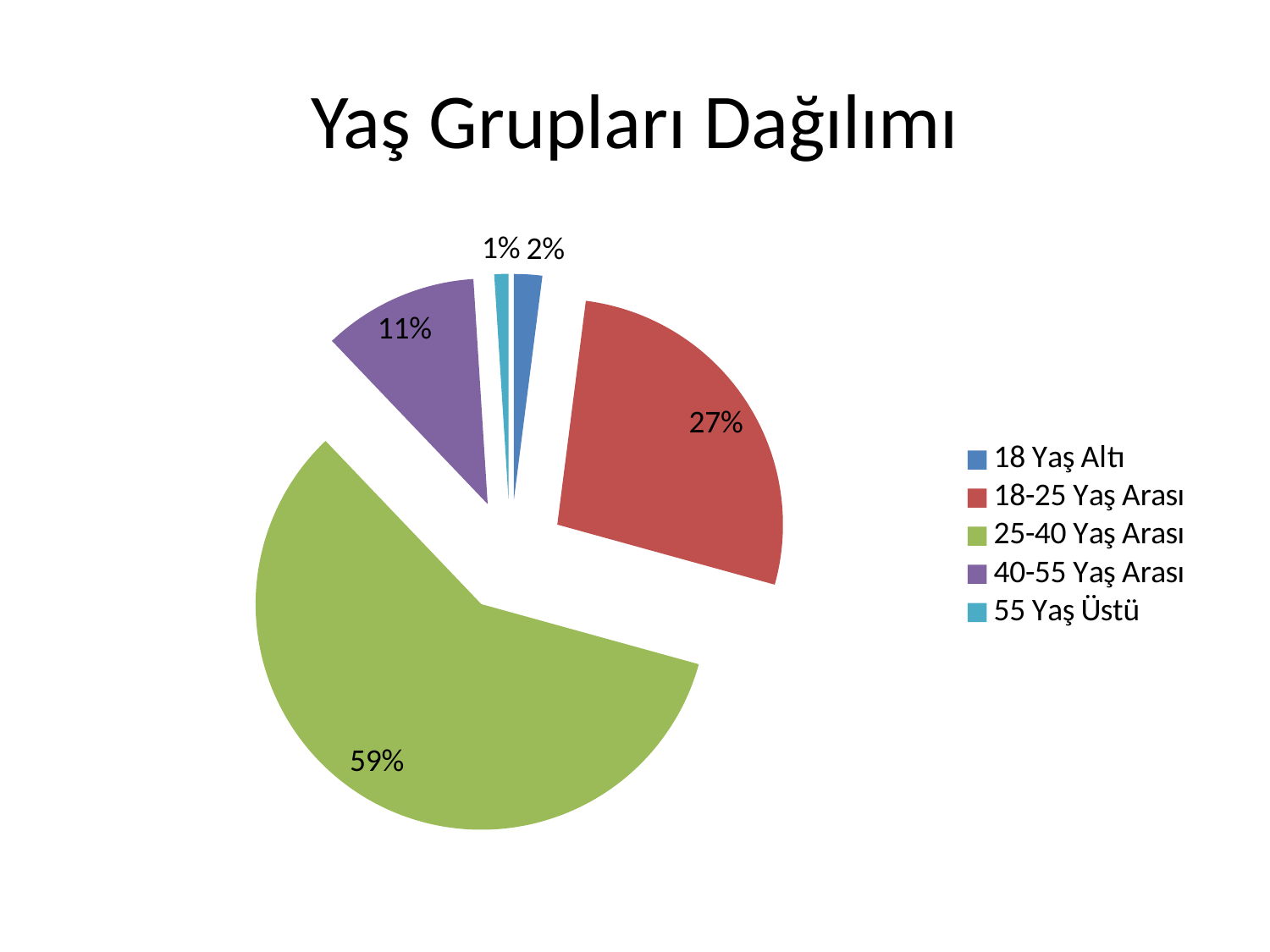
What share of the pie does 25-40 Yaş Arası have? 59% What type of chart is shown on the slide? pie chart What is the difference in percentage points between 25-40 Yaş Arası and 18-25 Yaş Arası? 32 What share of the pie does 18-25 Yaş Arası have? 27% Which age group has the smallest share of the pie? 55 Yaş Üstü What share of the pie does 55 Yaş Üstü have? 1% Which age group has the largest share of the pie? 25-40 Yaş Arası What is the title of the chart? Yaş Grupları Dağılımı Which is larger, the share for 18-25 Yaş Arası or the share for 40-55 Yaş Arası? 18-25 Yaş Arası How many categories does the legend list? 5